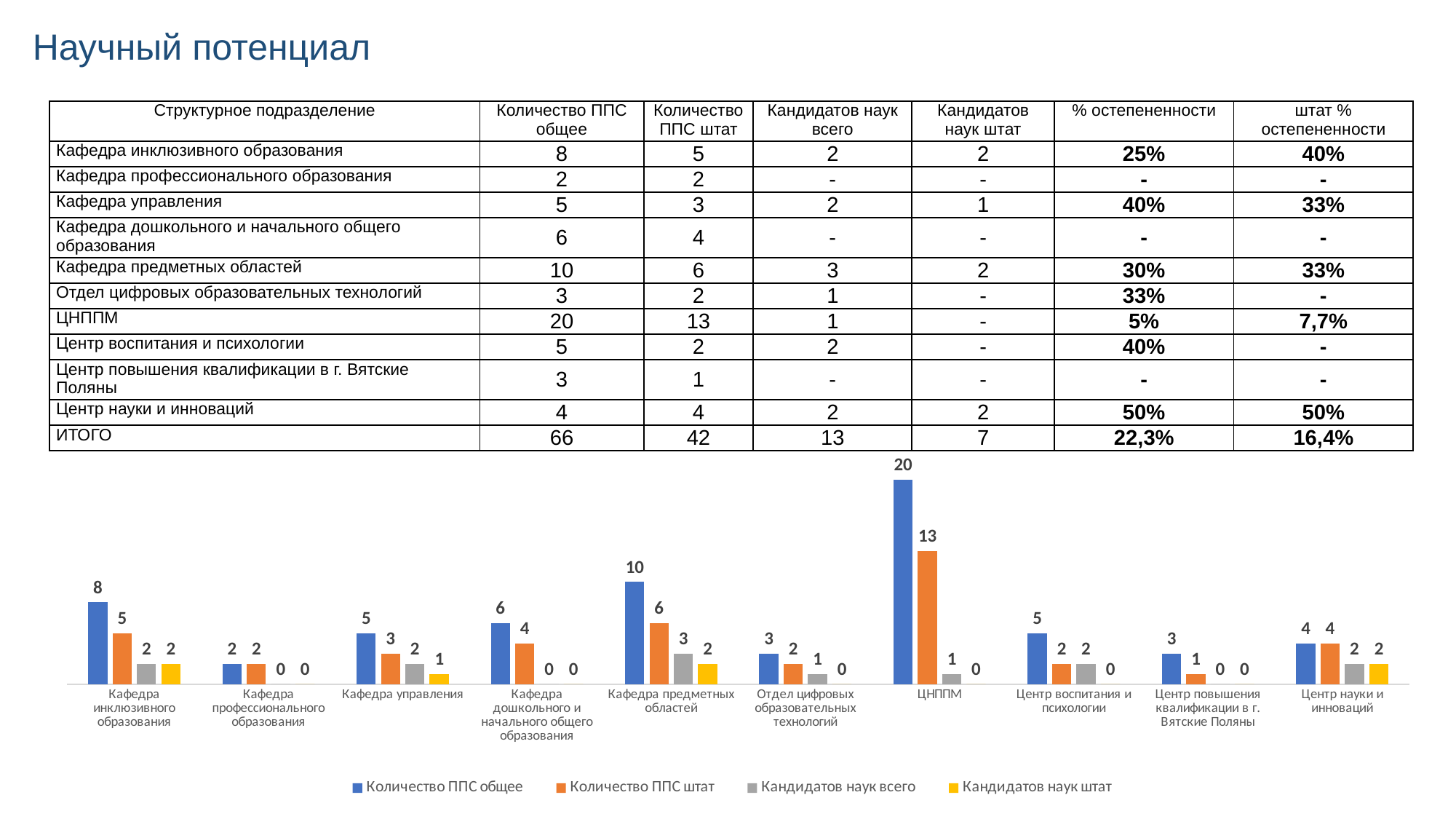
What is the value of Количество ППС штат for Кафедра предметных областей? 6 Which category has the lowest value of Количество ППС штат? Центр повышения квалификации в г. Вятские Поляны What is the value of Количество ППС общее for ЦНППМ? 20 How many series does the chart legend list? 4 What kind of chart is shown on the slide? bar chart How many categories are shown on the x axis of the chart? 10 Which series in the legend is shown in yellow? Кандидатов наук штат Which category has the highest value of Количество ППС общее? ЦНППМ What is the value of Кандидатов наук штат for Центр науки и инноваций? 2 Which is larger: Количество ППС общее for Кафедра инклюзивного образования or for Кафедра предметных областей? Кафедра предметных областей What is the value of Кандидатов наук всего for Кафедра управления? 2 What is the difference between Количество ППС общее and Количество ППС штат for ЦНППМ? 7